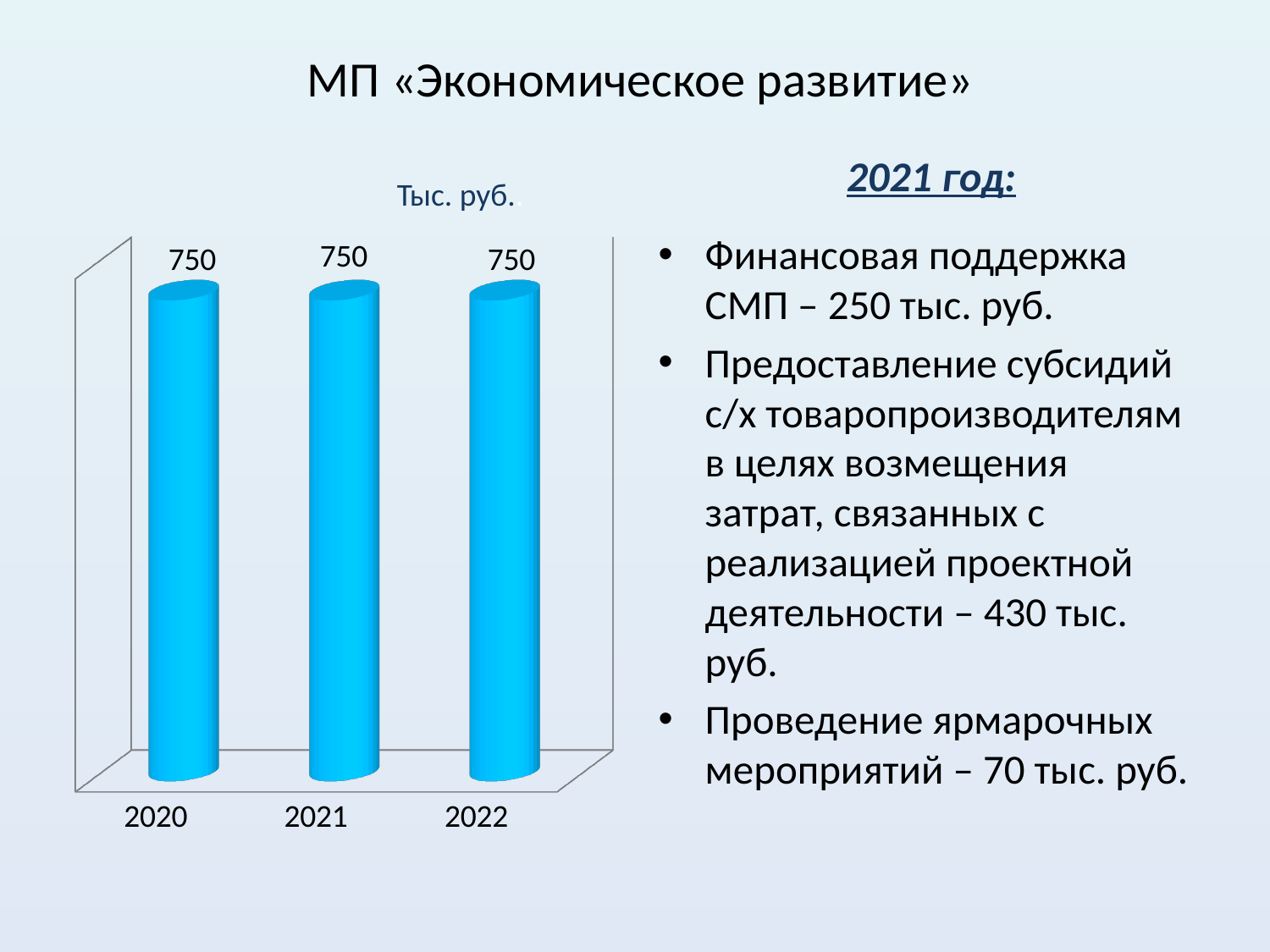
What is the difference between the values for 2020 and 2022? 0 What is the title shown above the chart? Тыс. руб. What is the value for 2021? 750 Do the values rise, fall or stay the same from 2020 to 2022? stay the same What is the value for 2020? 750 How many categories are shown on the x axis of the chart? 3 What colour are the bars in the chart? blue What is the value for 2022? 750 What kind of chart is shown on the slide? bar chart What is the total of the values for 2020, 2021 and 2022? 2250